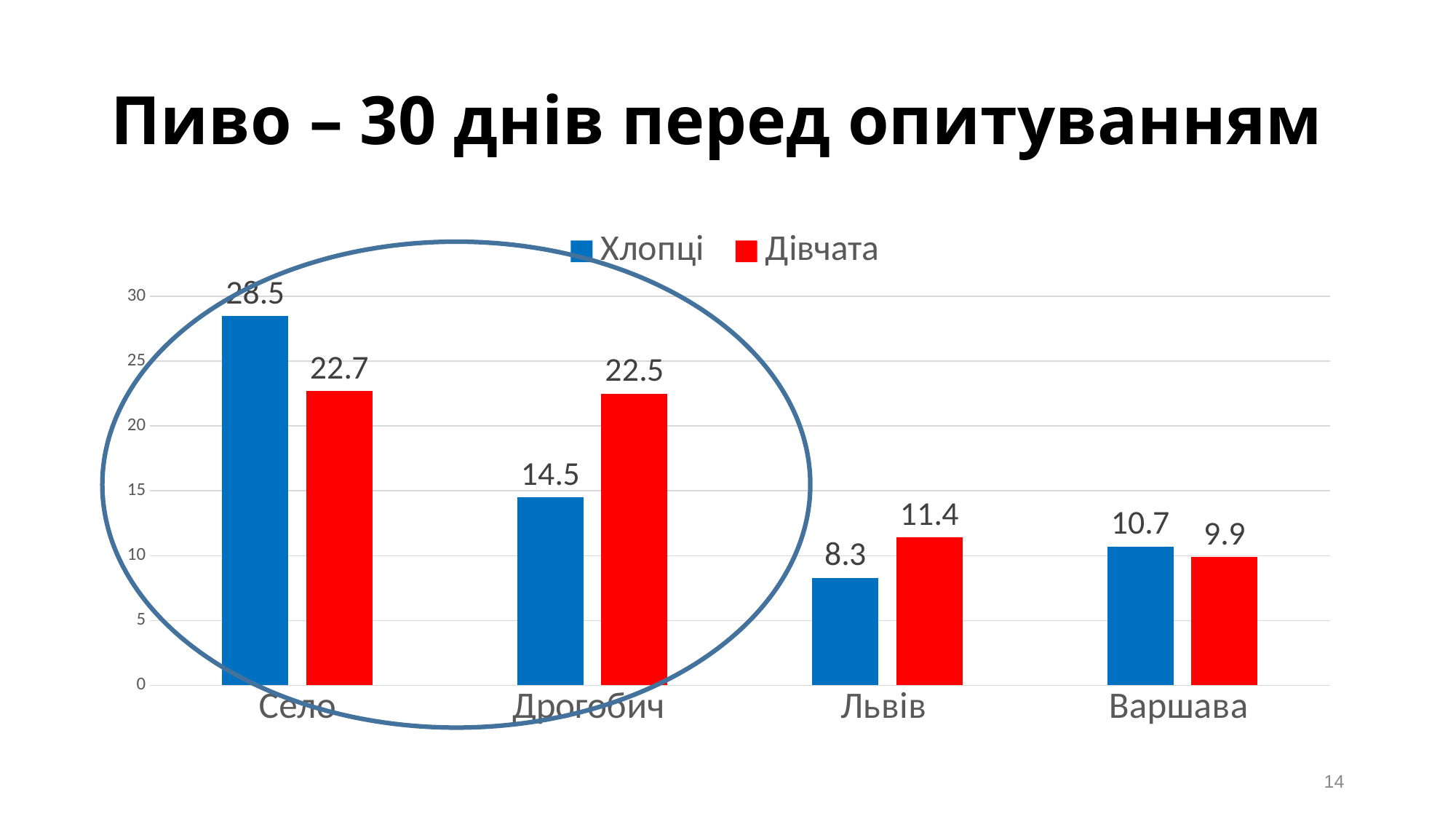
What is the difference between the Дівчата and Хлопці values in Дрогобич? 8 How many categories are shown on the x axis? 4 What is the value for Хлопці in Село? 28.5 Which category has the lowest value for Дівчата? Варшава How many series does the legend list? 2 What kind of chart is shown on the slide? Bar chart What is the value for Дівчата in Варшава? 9.9 Which category has the highest value for Хлопці? Село What colour represents the Дівчата series? Red Which is larger in Варшава, the value for Хлопці or for Дівчата? Хлопці What is the value for Дівчата in Дрогобич? 22.5 What is the value for Хлопці in Львів? 8.3